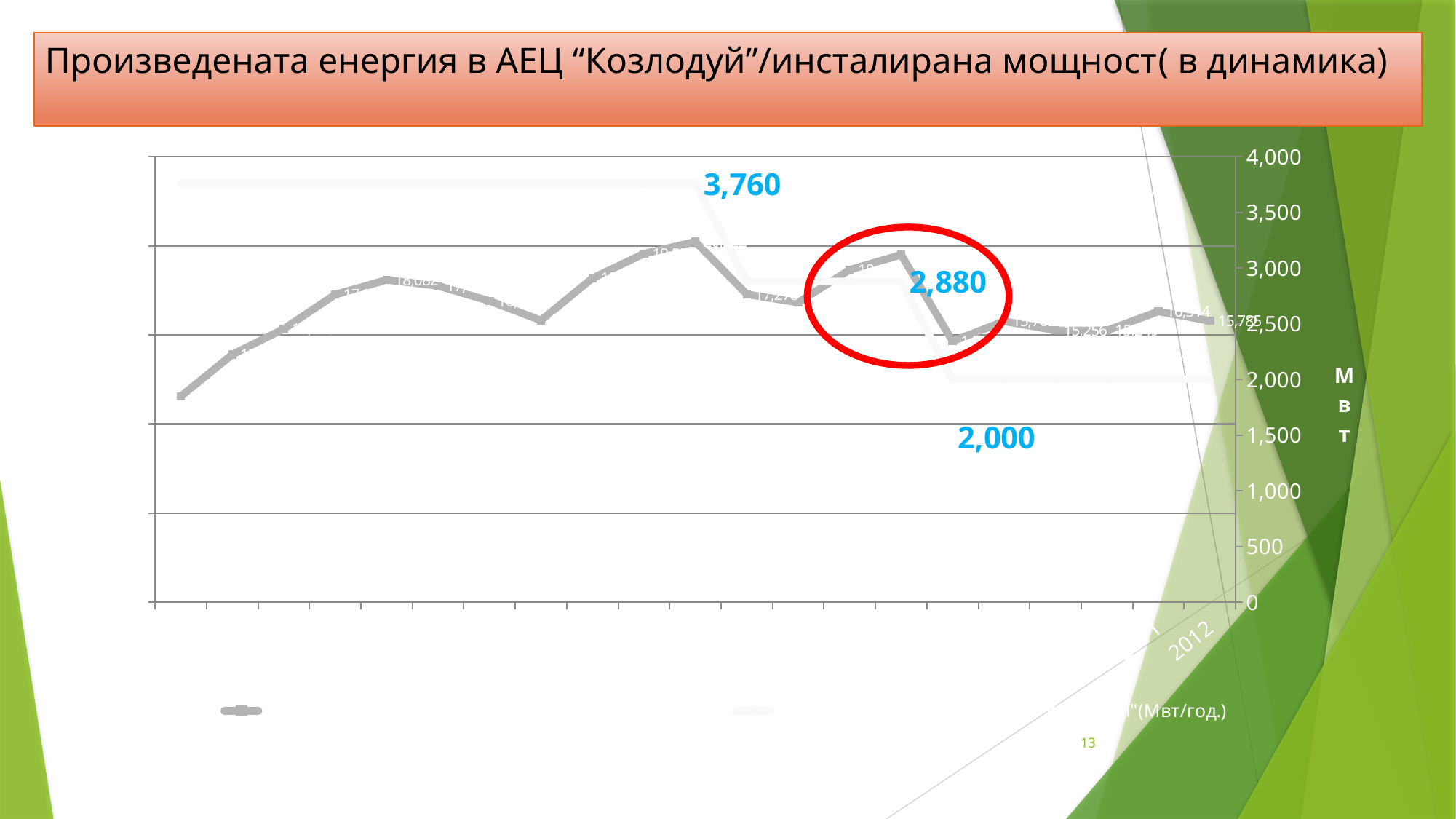
Which labelled installed-capacity value is larger, 2,880 or 2,000? 2,880 Does the installed-capacity (stepped) line rise or fall from left to right across the chart? fall What is the difference between the labelled installed-capacity values 3,760 and 2,880? 880 What is the lowest installed-capacity value labelled on the chart? 2,000 What is the difference between the labelled installed-capacity values 3,760 and 2,000? 1,760 What is the highest value shown on the right-hand vertical axis? 4,000 How many data series are plotted on the chart? 2 What is the title of the slide's chart? Произведената енергия в АЕЦ "Козлодуй"/инсталирана мощност( в динамика) What is the highest installed-capacity value labelled on the chart? 3,760 What is the last year label readable on the x axis? 2012 What kind of chart is shown on the slide? line chart